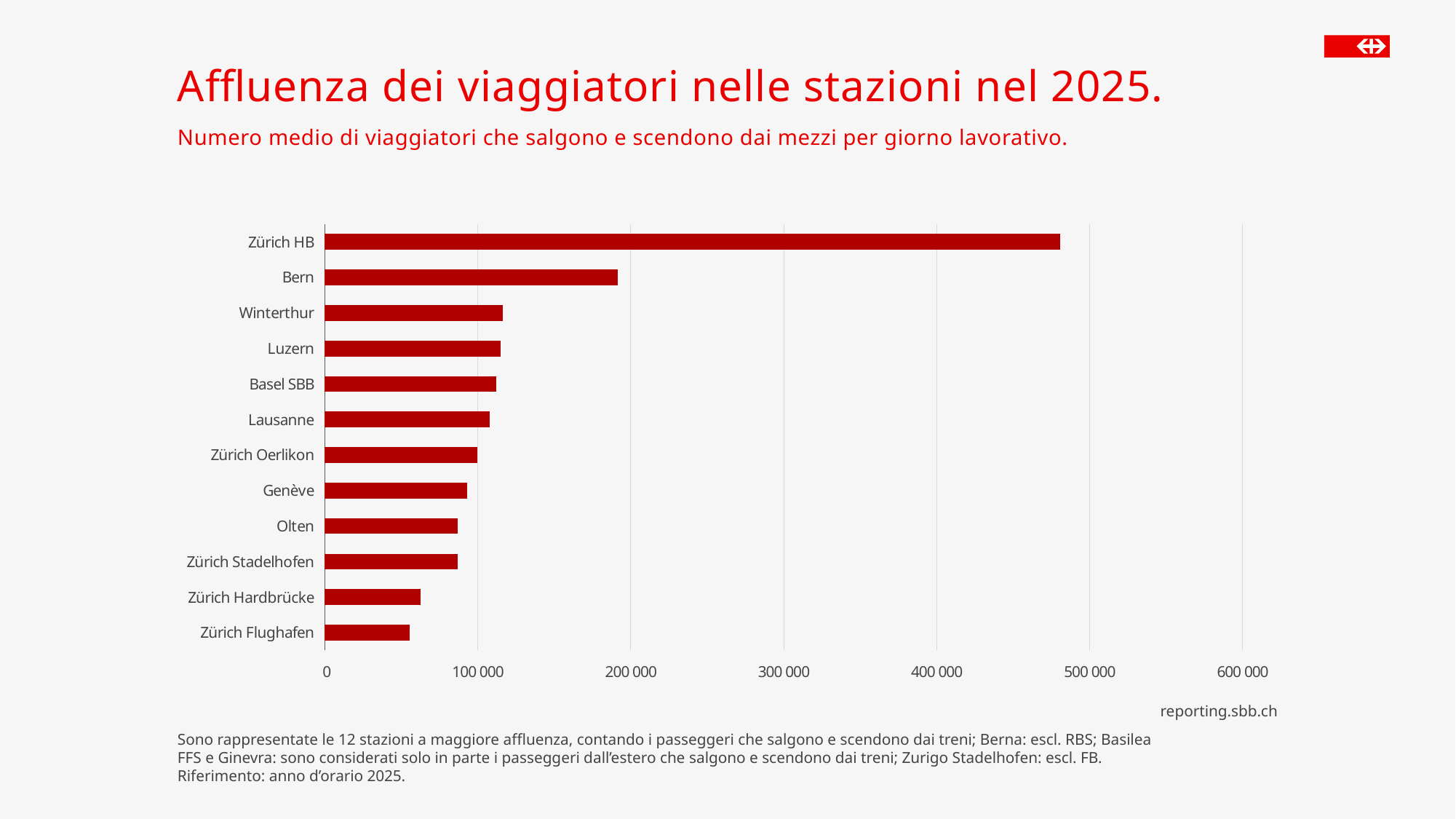
Which has a larger value, Zürich Hardbrücke or Zürich Flughafen? Zürich Hardbrücke Is the value for Winterthur greater or less than 100 000? greater How many stations are shown in the chart? 12 What kind of chart is shown on the slide? Bar chart What is the title of the slide? Affluenza dei viaggiatori nelle stazioni nel 2025. Which station has the lowest number of passengers in the chart? Zürich Flughafen Is the value for Zürich Flughafen greater or less than 100 000? less Which station has the highest number of passengers in the chart? Zürich HB Is the value for Zürich HB greater or less than 400 000? greater Which has a larger value, Bern or Winterthur? Bern What colour are the bars in the chart? Red